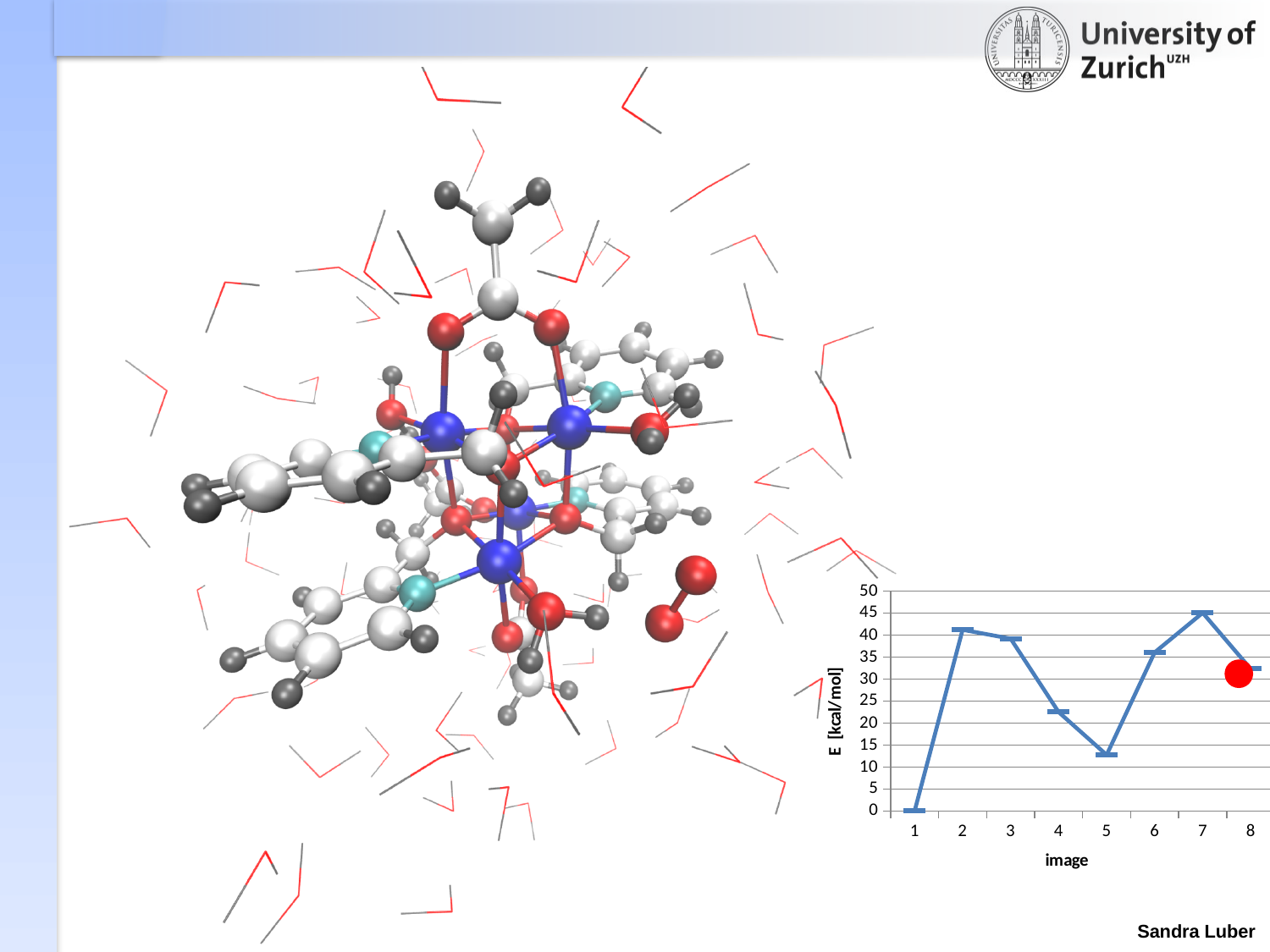
What is the label of the x axis on the chart? image Do the values rise or fall from image 2 to image 5? fall What is the label of the y axis on the chart? E [kcal/mol] How many images (data points) are plotted on the chart? 8 Which has the larger energy value, image 2 or image 5? image 2 What is the energy value for image 1? 0 What kind of chart is shown on the slide? line chart What is the energy value for image 7? 45 Which image has the lowest energy on the chart? 1 Which image has the highest energy on the chart? 7 Is the value for image 4 greater or less than 25? less Is the value for image 5 greater or less than 15? less